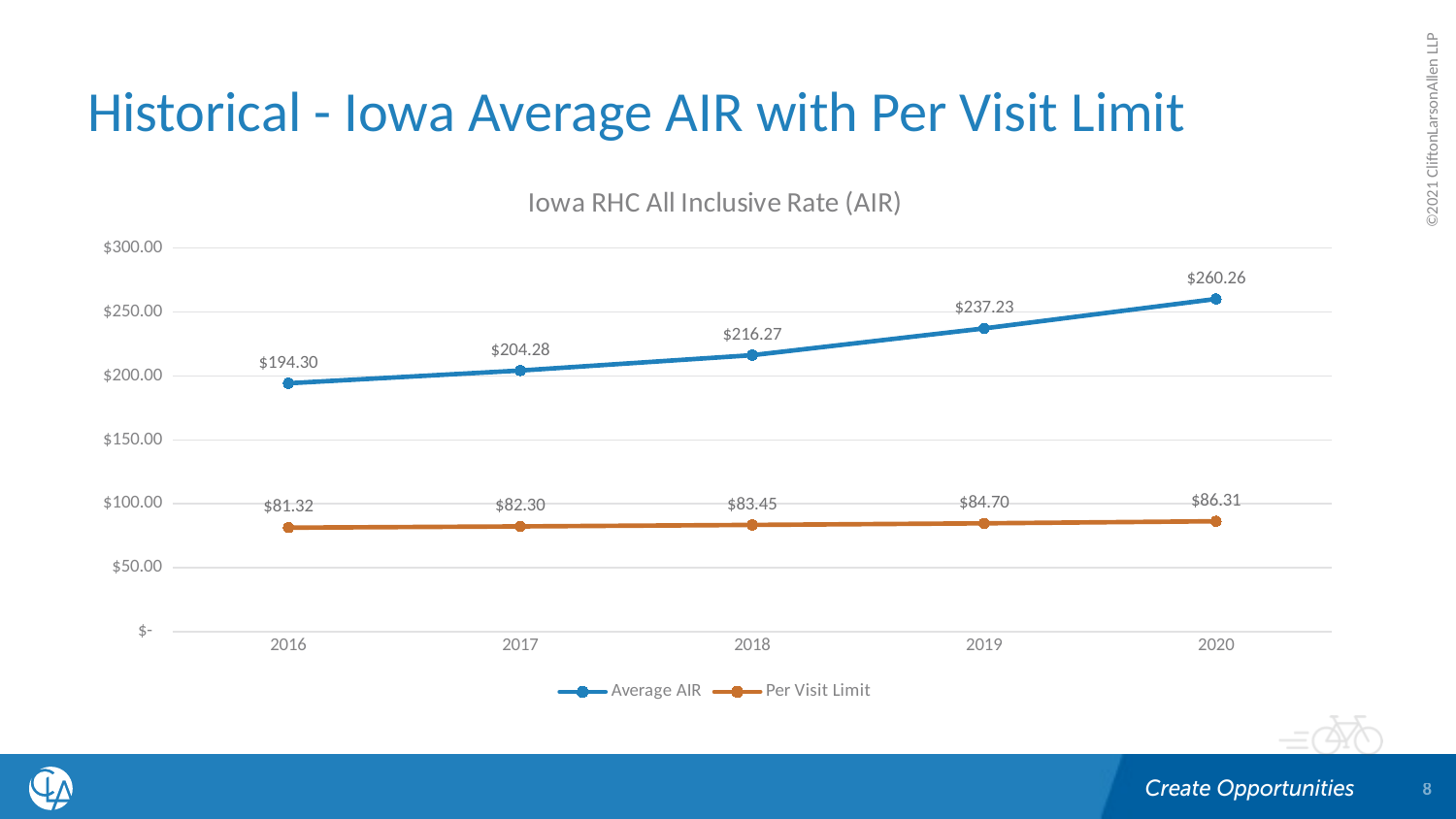
What is the Per Visit Limit value for 2019? $84.70 Which is larger in 2017: the Average AIR or the Per Visit Limit? Average AIR How many years are shown on the x axis? 5 In which year is the Per Visit Limit lowest? 2016 What is the difference between the Average AIR in 2020 and in 2019? $23.03 Is the Average AIR value for 2019 greater or less than $200.00? greater What is the Average AIR value for 2016? $194.30 What is the Average AIR value for 2018? $216.27 What kind of chart is shown on the slide? Line chart In which year is the Average AIR highest? 2020 What is the difference between the Average AIR and the Per Visit Limit in 2016? $112.98 How many series does the legend list? 2